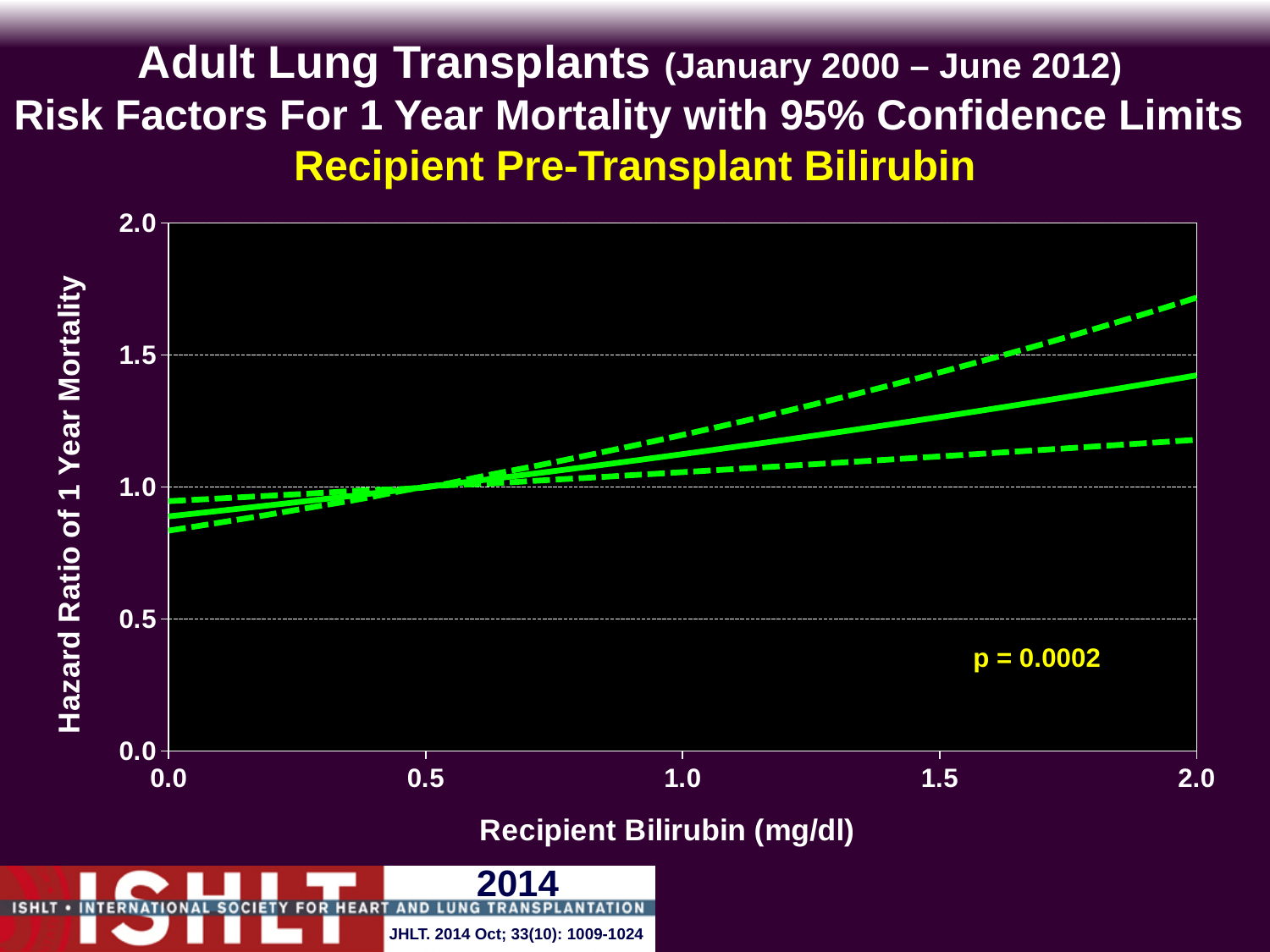
What is the label of the y axis? Hazard Ratio of 1 Year Mortality Does the hazard ratio of 1 year mortality rise or fall as recipient bilirubin increases from 0.0 to 2.0 mg/dl? rise How many lines are plotted on the chart? 3 Is the hazard ratio (solid line) at a recipient bilirubin of 2.0 mg/dl greater or less than 1.0? greater Is the hazard ratio (solid line) at a recipient bilirubin of 2.0 mg/dl greater or less than 1.5? less What kind of chart is shown on the slide? line chart What p-value is shown on the chart? p = 0.0002 Is the lower 95% confidence limit at a recipient bilirubin of 2.0 mg/dl greater or less than 1.5? less Is the hazard ratio at a recipient bilirubin of 2.0 mg/dl larger or smaller than at 0.0 mg/dl? larger